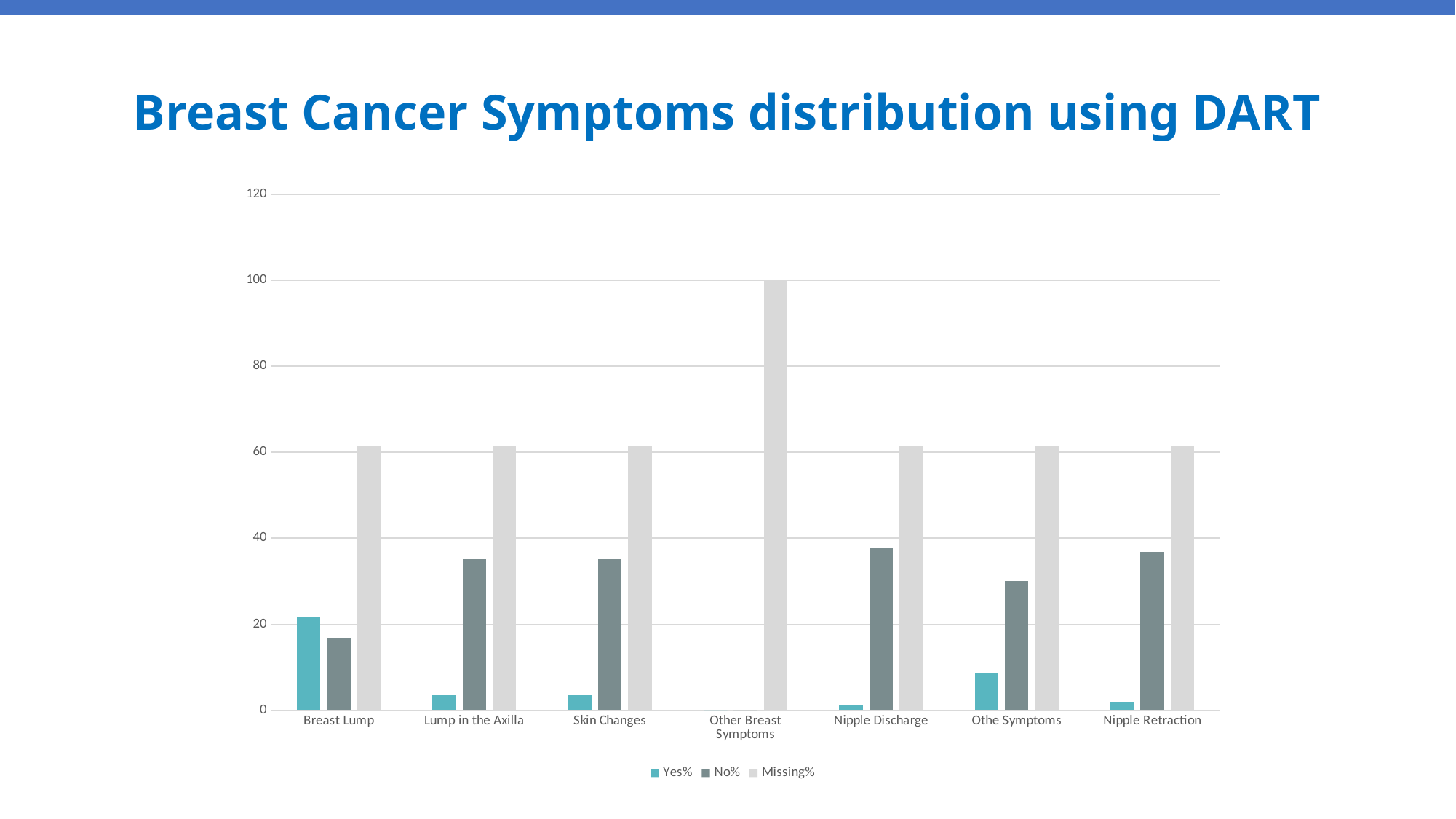
How many symptom categories are shown on the x axis? 7 Is the Missing% value for Skin Changes greater or less than 80? less What kind of chart is shown on the slide? Bar chart What is the title of the chart? Breast Cancer Symptoms distribution using DART Which category has the highest Missing% value? Other Breast Symptoms Is the No% value for Nipple Discharge greater or less than 20? greater What is the Missing% value for Other Breast Symptoms? 100 How many series does the legend list? 3 For Breast Lump, which is larger: the Yes% value or the No% value? Yes% For Lump in the Axilla, which is larger: the Yes% value or the No% value? No% Which category has the highest Yes% value? Breast Lump Is the Yes% value for Breast Lump greater or less than 40? less